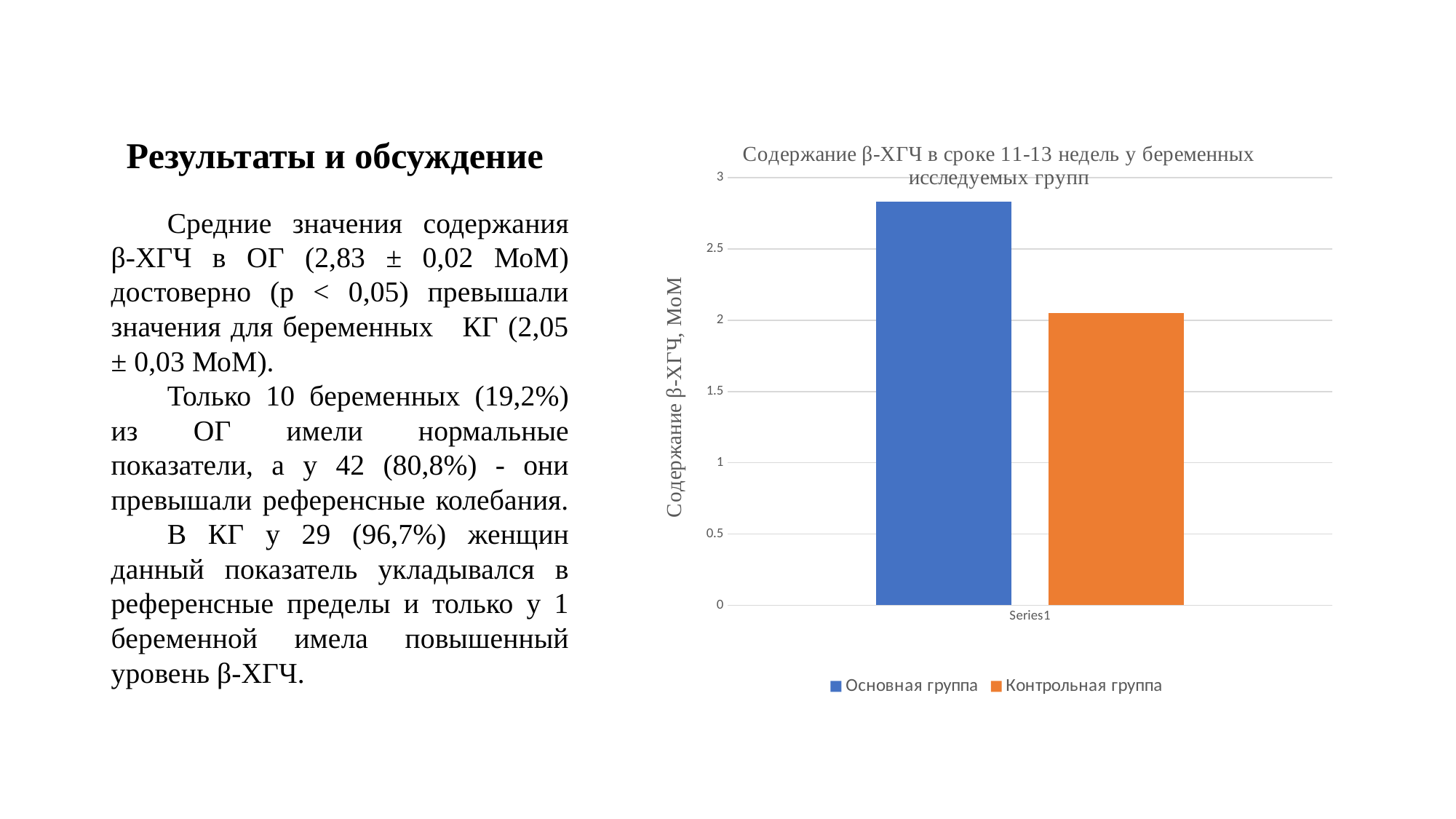
Which series has the lowest bar? Контрольная группа Is the value for Контрольная группа greater or less than 1.5? greater How many series does the legend list? 2 Is the value for Основная группа greater or less than 3? less Which series has the higher value, Основная группа or Контрольная группа? Основная группа Is the value for Контрольная группа greater or less than 2.5? less Which series has the highest bar? Основная группа What is the label of the y axis? Содержание β-ХГЧ, МоМ How many categories are shown on the x axis? 1 What kind of chart is shown on the slide? bar chart What colour is the bar for Контрольная группа? orange